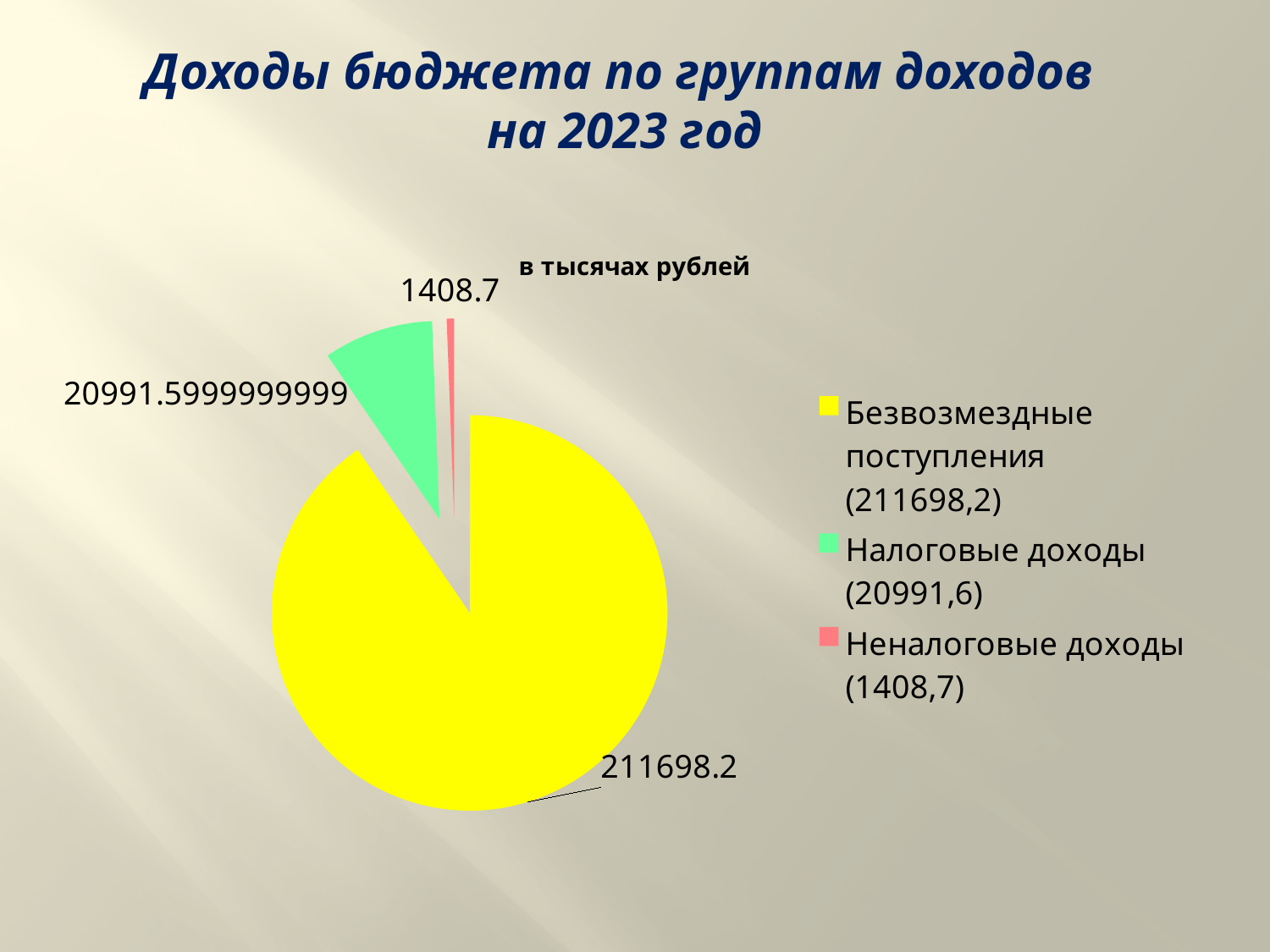
Which is larger, Налоговые доходы or Неналоговые доходы? Налоговые доходы What is the total of all three categories in the pie chart? 234098.5 What is the data label value for Безвозмездные поступления in the pie chart? 211698.2 What is the data label value for Неналоговые доходы in the pie chart? 1408.7 Which category has the largest slice in the pie chart? Безвозмездные поступления What type of chart is shown on the slide? Pie chart How many slices does the pie chart have? 3 How many entries does the legend of the pie chart list? 3 What is the difference between Налоговые доходы (20991,6) and Неналоговые доходы (1408,7)? 19582.9 What value does the legend give for Налоговые доходы? 20991,6 Which category has the smallest slice in the pie chart? Неналоговые доходы What unit is stated in the chart title above the pie? в тысячах рублей